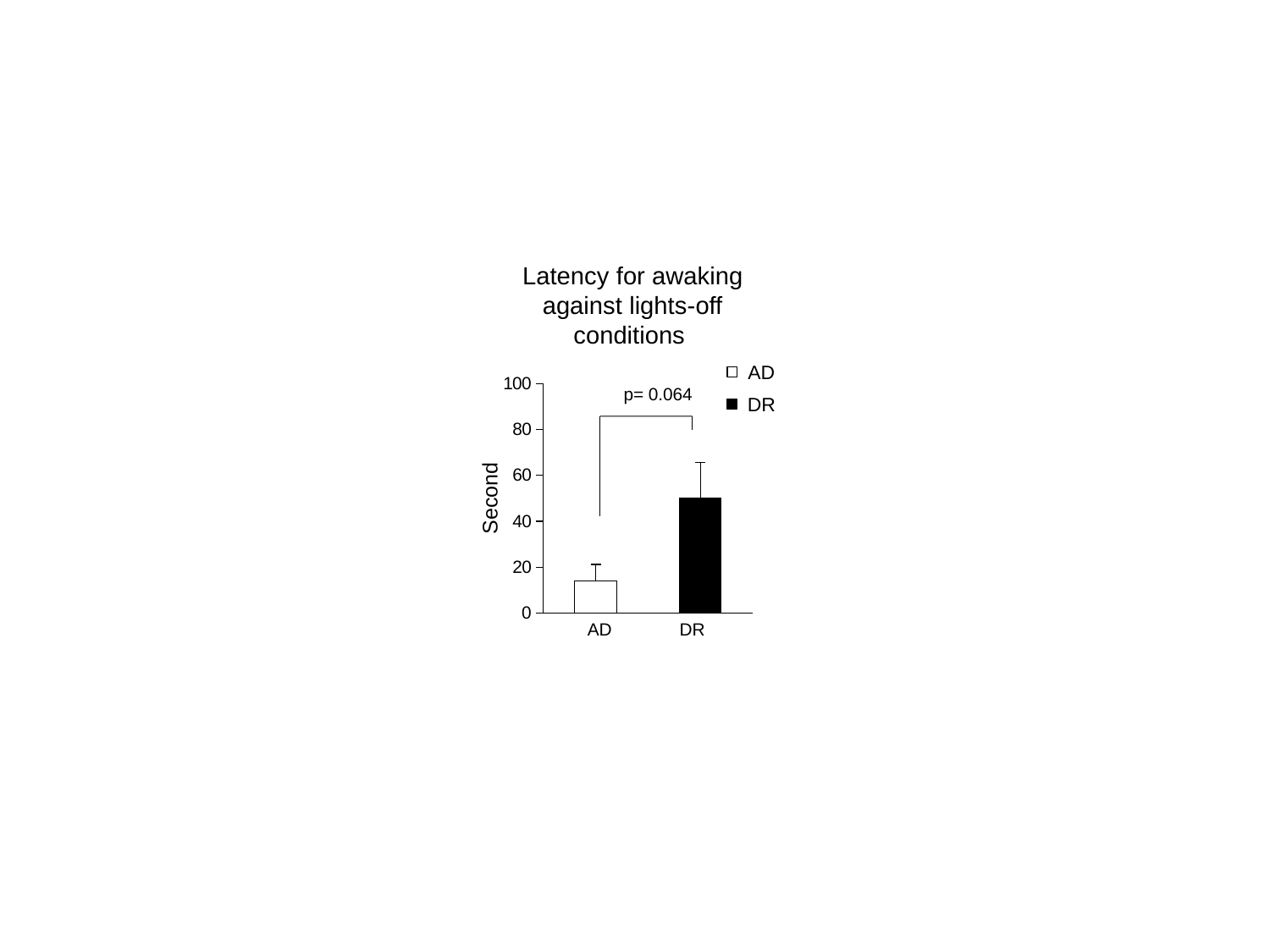
Is the value for DR greater or less than 60? less How many bars are plotted in the chart? 2 Which bar is the shortest in the chart? AD Is the value for AD greater or less than 20? less Which bar is the tallest in the chart? DR Which group has the higher latency for awaking, AD or DR? DR What p-value is annotated between the AD and DR bars? p= 0.064 Is the value for DR greater or less than 40? greater What kind of chart is shown on the slide? bar chart What is the title of the chart? Latency for awaking against lights-off conditions How many entries does the legend list? 2